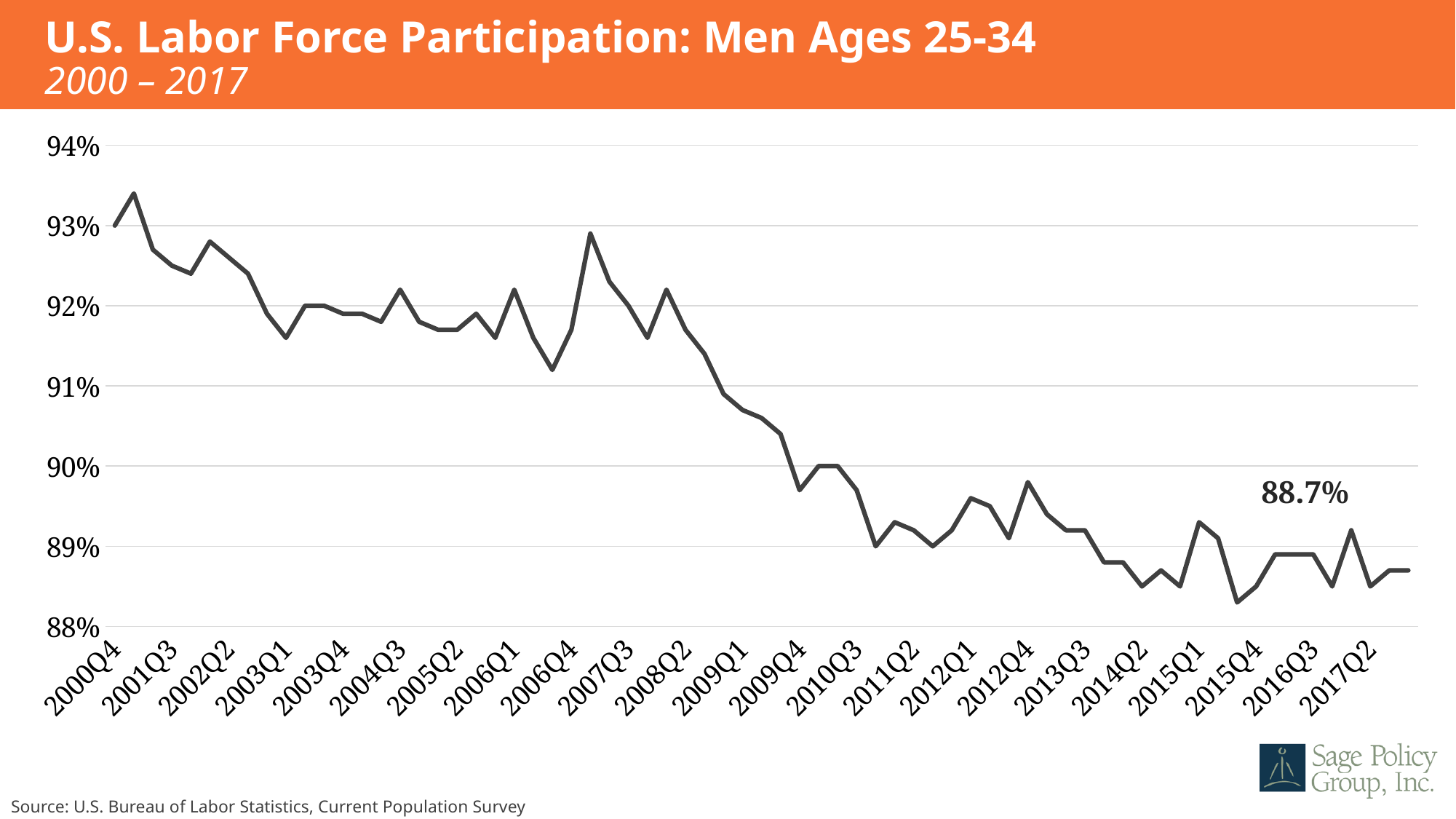
Is the value for 2009Q1 greater or less than 92%? less Is the value for 2012Q4 greater or less than 90%? less What is the title of the chart? U.S. Labor Force Participation: Men Ages 25-34 What source is cited for the chart data? U.S. Bureau of Labor Statistics, Current Population Survey What is the value printed as a data label at the end of the line? 88.7% Is the value for 2000Q4 greater or less than the value for 2017Q2? greater Overall, do the values rise or fall from 2000Q4 to 2017? fall What kind of chart is shown on the slide? line chart Is the value for 2015Q4 greater or less than 89%? less